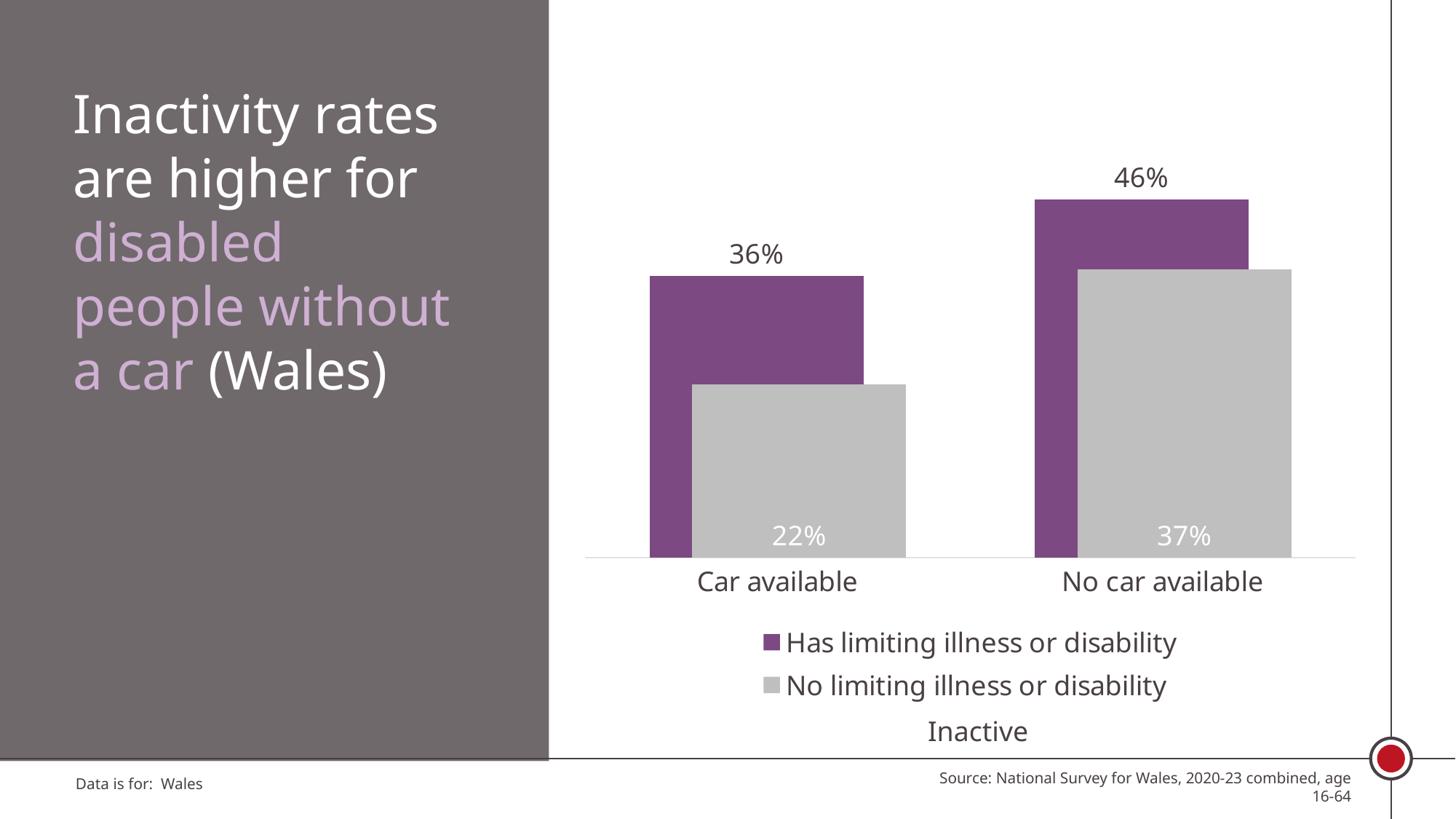
What is the inactivity rate for people with a limiting illness or disability who have a car available? 36% What kind of chart is shown on the slide? Bar chart How many categories are shown on the x axis? 2 What is the inactivity rate for people with no limiting illness or disability who have no car available? 37% Which bar shows the lowest inactivity rate? No limiting illness or disability, Car available Which bar shows the highest inactivity rate? Has limiting illness or disability, No car available Which is larger: the inactivity rate for disabled people with a car available, or for non-disabled people with no car available? Non-disabled people with no car available (37%) What is the difference in inactivity rate between disabled people with no car available and disabled people with a car available? 10 percentage points What is the difference in inactivity rate between people with and without a limiting illness or disability in the 'Car available' group? 14 percentage points What is the inactivity rate for people with a limiting illness or disability who have no car available? 46% What is the inactivity rate for people with no limiting illness or disability who have a car available? 22% How many series does the legend list? 2